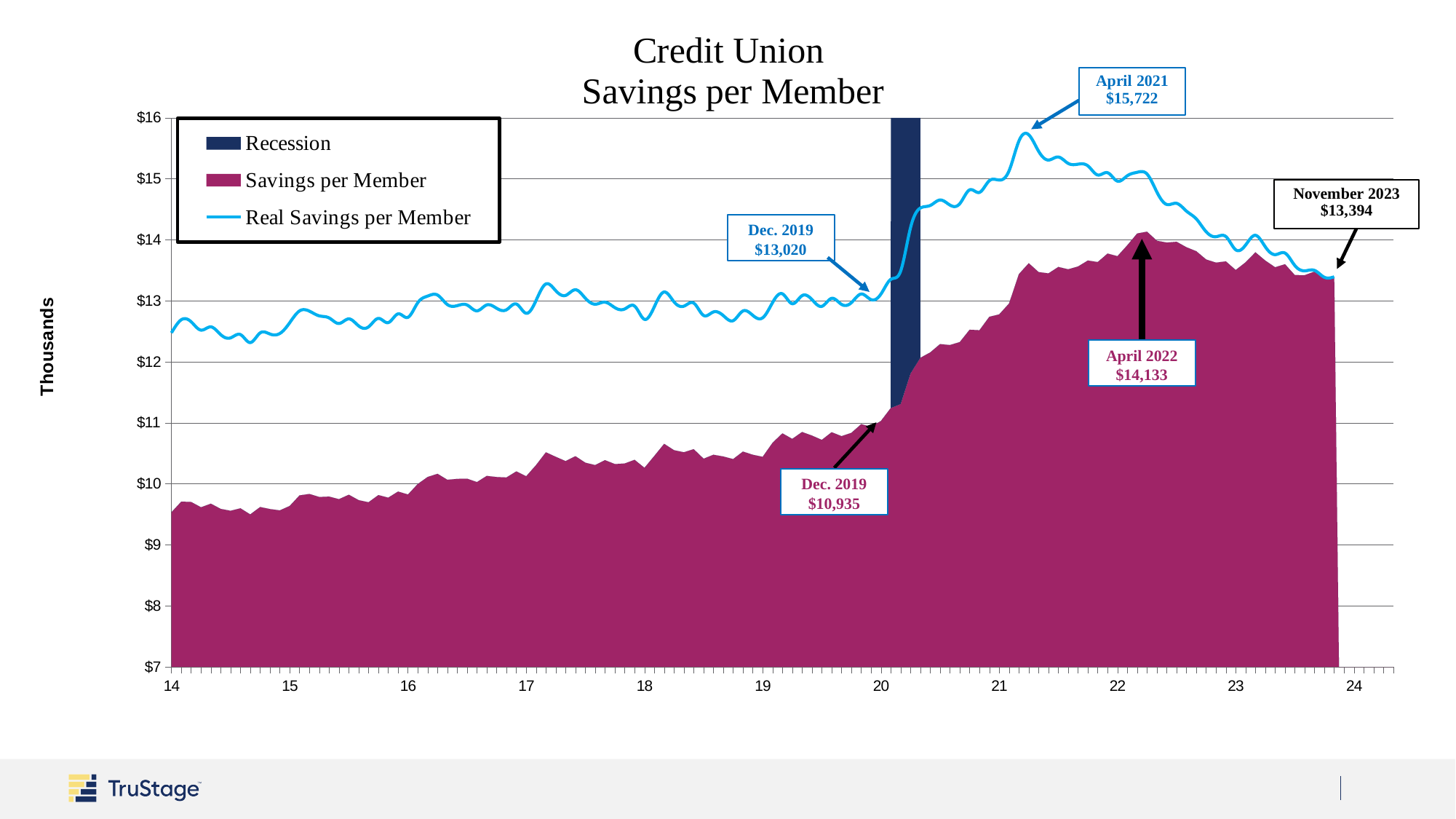
What was Savings per Member in April 2022? $14,133 How much higher was Savings per Member in April 2022 than in Dec. 2019? $3,198 What does the dark blue vertical bar in the chart represent? Recession How many entries does the legend list? 3 Does Savings per Member generally rise or fall from 2014 to 2022? rise What is the difference between Real Savings per Member and Savings per Member in Dec. 2019? $2,085 What was Real Savings per Member in April 2021? $15,722 What value is annotated for November 2023? $13,394 What was Savings per Member in Dec. 2019? $10,935 Which is larger: Real Savings per Member in April 2021 or Savings per Member in April 2022? Real Savings per Member in April 2021 Is Savings per Member at the start of 2014 greater or less than $10? less What was Real Savings per Member in Dec. 2019? $13,020